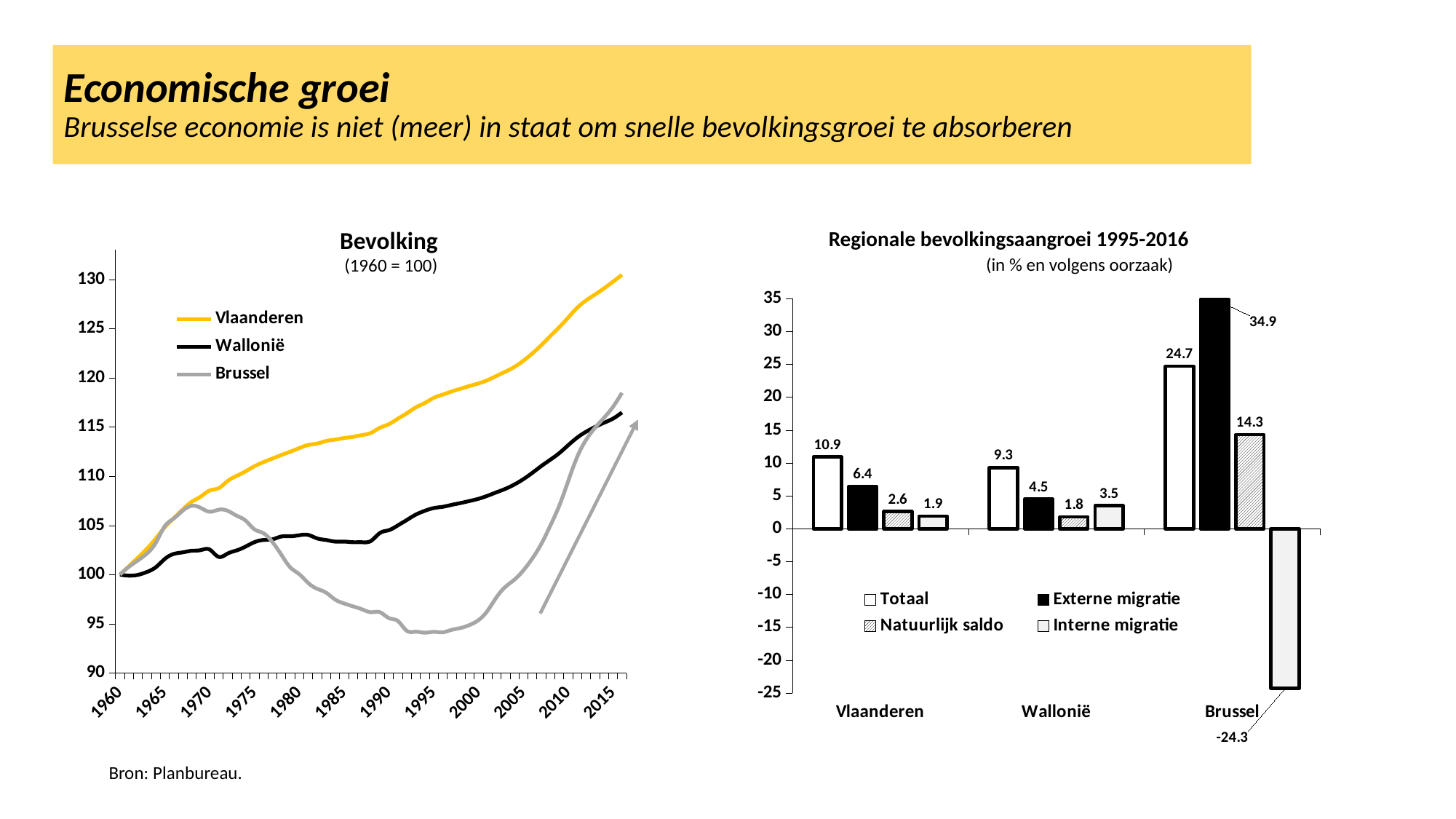
On the chart titled 'Bevolking', does the Vlaanderen line rise or fall from 1960 to 2015? Rises What kind of chart is the chart titled 'Bevolking'? Line chart On the chart titled 'Regionale bevolkingsaangroei 1995-2016', which is larger: Interne migratie for Vlaanderen or Interne migratie for Wallonië? Wallonië On the chart titled 'Regionale bevolkingsaangroei 1995-2016', what is the Interne migratie value for Brussel? -24.3 On the chart titled 'Regionale bevolkingsaangroei 1995-2016', what is the difference between the Totaal values for Vlaanderen and Wallonië? 1.6 On the chart titled 'Regionale bevolkingsaangroei 1995-2016', which region has the lowest Natuurlijk saldo value? Wallonië On the chart titled 'Regionale bevolkingsaangroei 1995-2016', which region has the highest Totaal value? Brussel On the chart titled 'Regionale bevolkingsaangroei 1995-2016', what is the Externe migratie value for Wallonië? 4.5 On the chart titled 'Bevolking', how many series does the legend list? 3 On the chart titled 'Regionale bevolkingsaangroei 1995-2016', how many series does the legend list? 4 On the chart titled 'Bevolking', is the value for Brussel in 1995 greater or less than 95? less On the chart titled 'Regionale bevolkingsaangroei 1995-2016', what is the Totaal value for Brussel? 24.7